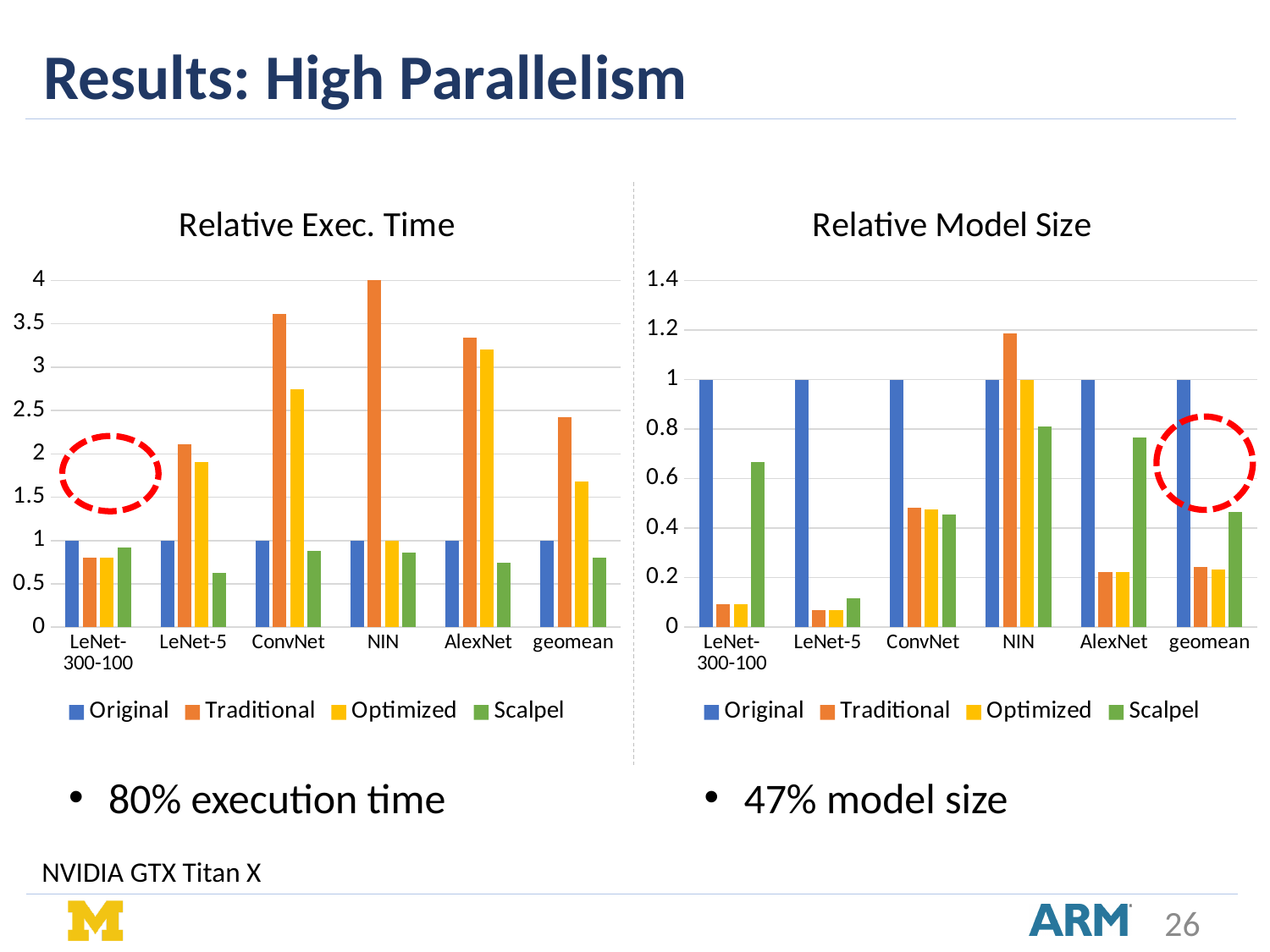
On the Relative Model Size chart, for geomean, which is larger: the Scalpel value or the Optimized value? Scalpel On the Relative Exec. Time chart, which category has the lowest Scalpel value? LeNet-5 On the Relative Exec. Time chart, is the Traditional value for ConvNet greater or less than 3.5? greater On the Relative Exec. Time chart, what is the value of the Original series for LeNet-5? 1 On the Relative Model Size chart, which category has the lowest Scalpel value? LeNet-5 On the Relative Exec. Time chart, how many categories are shown on the x axis? 6 How many series does the legend of the Relative Model Size chart list? 4 On the Relative Exec. Time chart, which category has the highest Traditional value? NIN On the Relative Model Size chart, is the Scalpel value for AlexNet greater or less than 0.6? greater On the Relative Model Size chart, which category has the highest Traditional value? NIN On the Relative Model Size chart, what is the value of the Original series for ConvNet? 1 On the Relative Exec. Time chart, for ConvNet, which is larger: the Traditional value or the Optimized value? Traditional